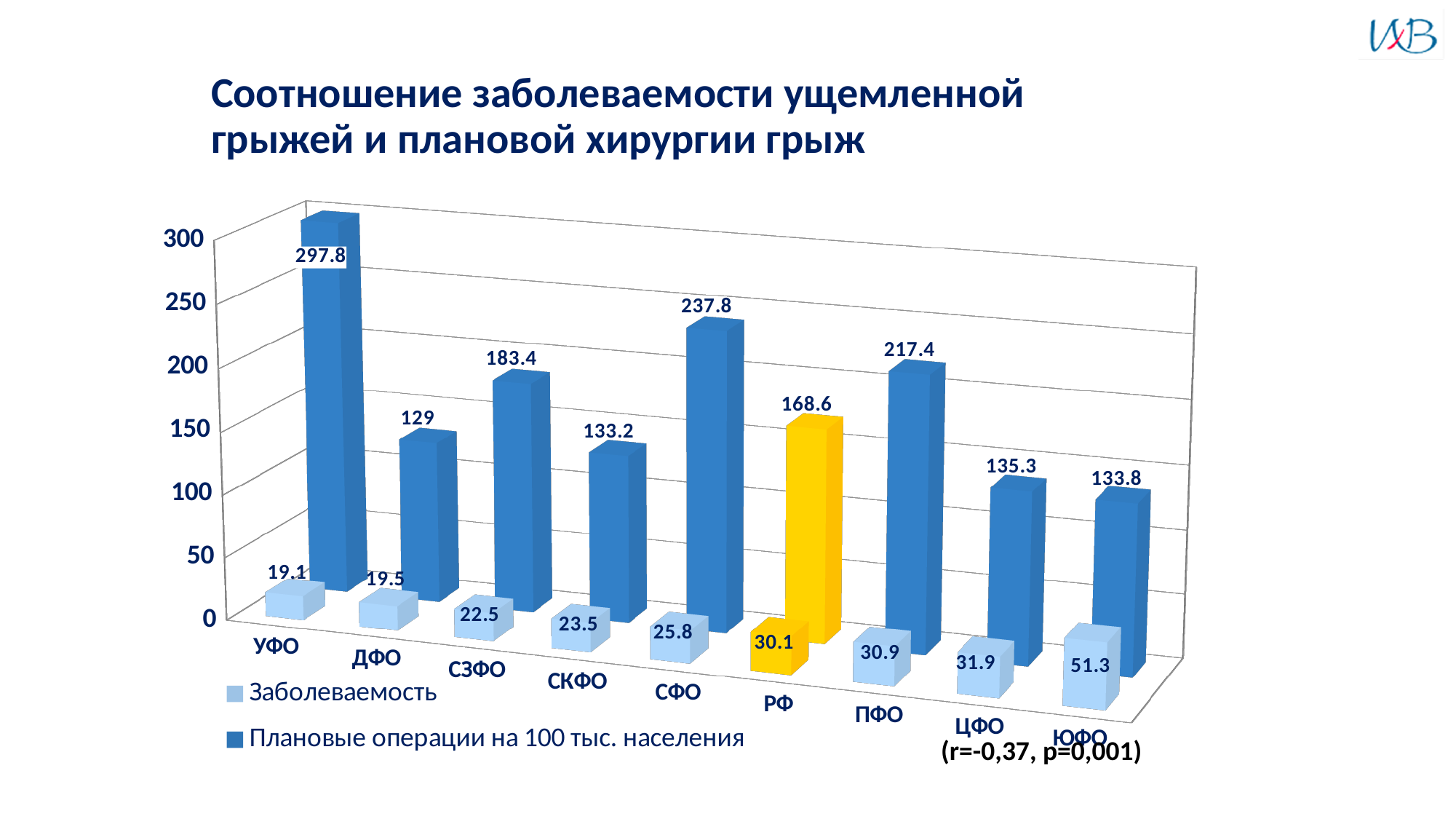
What is the value of Плановые операции на 100 тыс. населения for РФ? 168.6 What kind of chart is shown on the slide? Bar chart Which is larger: the Плановые операции на 100 тыс. населения value for СЗФО or for ЦФО? СЗФО Which category has the lowest value for Заболеваемость? УФО What is the value of Заболеваемость for ЮФО? 51.3 What is the difference between the Плановые операции на 100 тыс. населения values for СФО and ПФО? 20.4 Which category's bars are highlighted in yellow? РФ How many categories are shown on the x axis? 9 What is the value of Плановые операции на 100 тыс. населения for УФО? 297.8 Which category has the highest value for Плановые операции на 100 тыс. населения? УФО Which category has the lowest value for Плановые операции на 100 тыс. населения? ДФО How many series does the legend list? 2